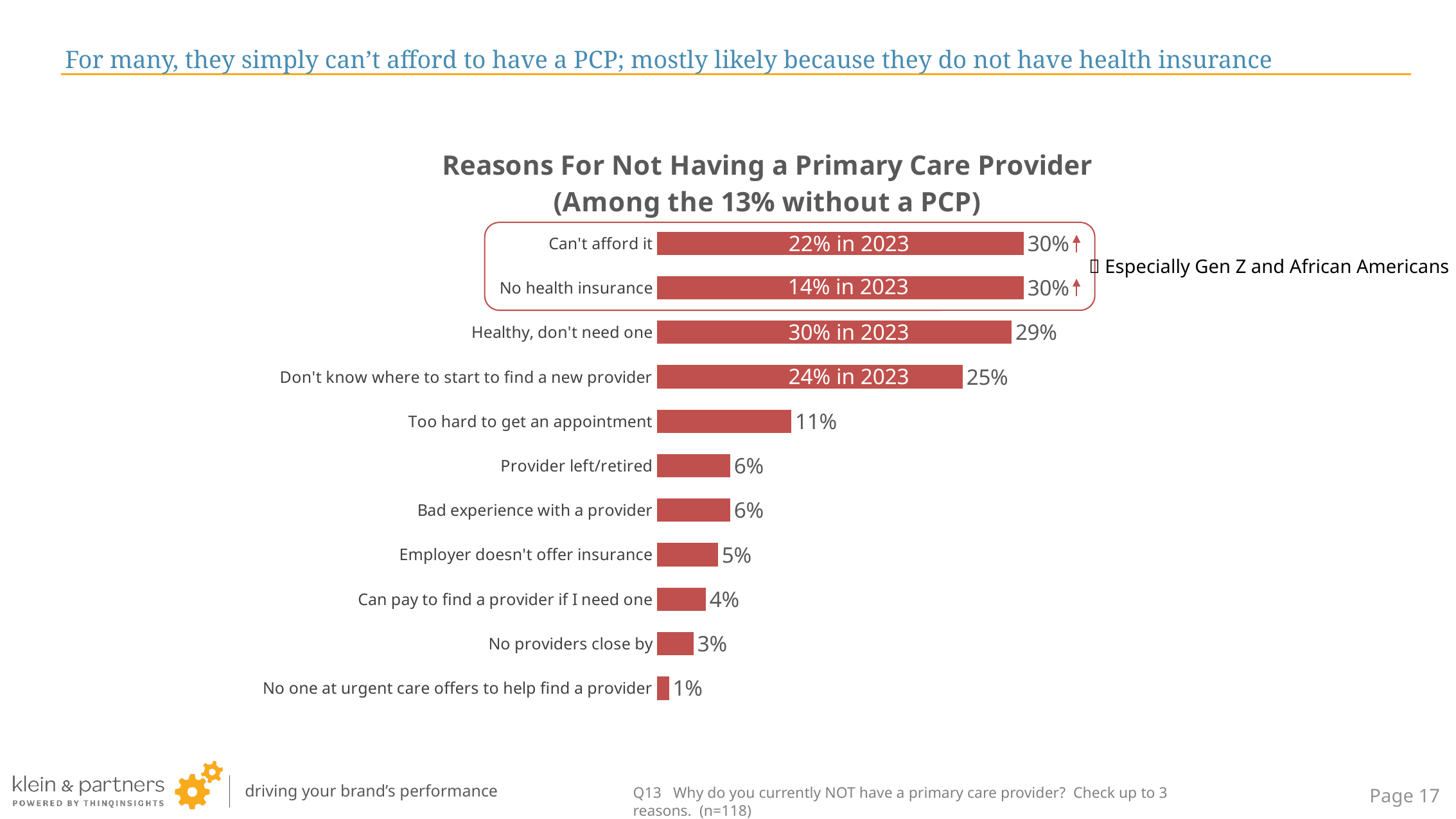
How many categories are shown in the chart? 11 By how much did "No health insurance" change from its 2023 value to the current value? 16% What is the value for "Healthy, don't need one"? 29% Which is larger, "Employer doesn't offer insurance" or "No providers close by"? Employer doesn't offer insurance Which two categories are highlighted with a red outline box? Can't afford it and No health insurance What is the value for "Can pay to find a provider if I need one"? 4% What was the 2023 value shown for "No health insurance"? 14% in 2023 What is the difference between "Don't know where to start to find a new provider" and "Too hard to get an appointment"? 14% What kind of chart is this? Bar chart Which category has the lowest value? No one at urgent care offers to help find a provider What is the title of the chart? Reasons For Not Having a Primary Care Provider (Among the 13% without a PCP) What is the value for "Too hard to get an appointment"? 11%